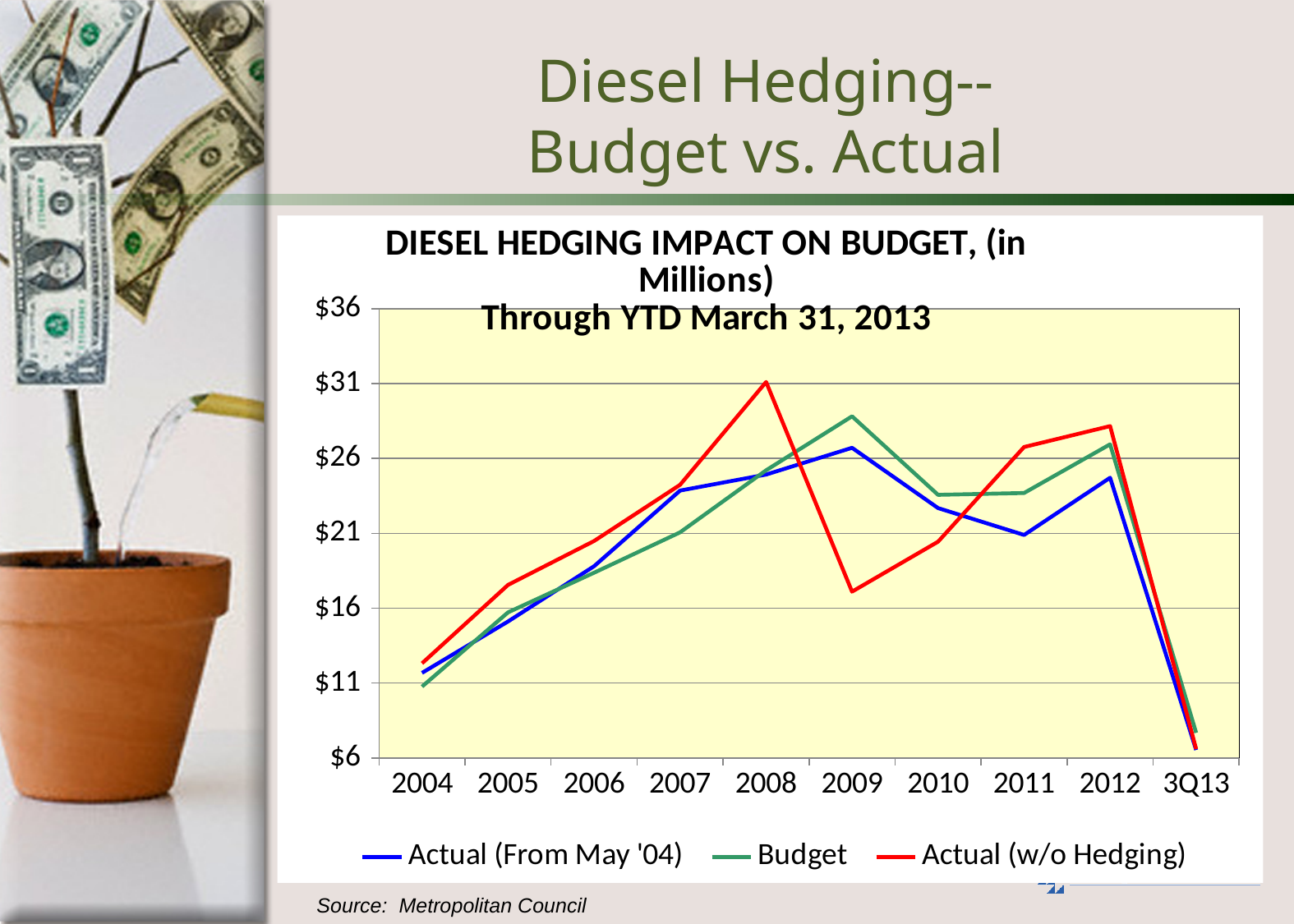
What type of chart is shown on the slide? Line chart In which period does the Budget series reach its lowest value? 3Q13 In 2009, which is higher: Budget or Actual (w/o Hedging)? Budget Is the Actual (w/o Hedging) value for 2009 greater or less than $16? greater In which year does the Actual (w/o Hedging) series reach its highest value? 2008 Is the Budget value for 2010 greater or less than $21? greater In which year does the Budget series reach its highest value? 2009 How many series does the legend list? 3 What colour is the line for the Budget series? Green How many time periods are shown along the x axis? 10 Does the Budget series rise or fall from 2004 to 2009? Rises In 2008, which is higher: Actual (w/o Hedging) or Actual (From May '04)? Actual (w/o Hedging)